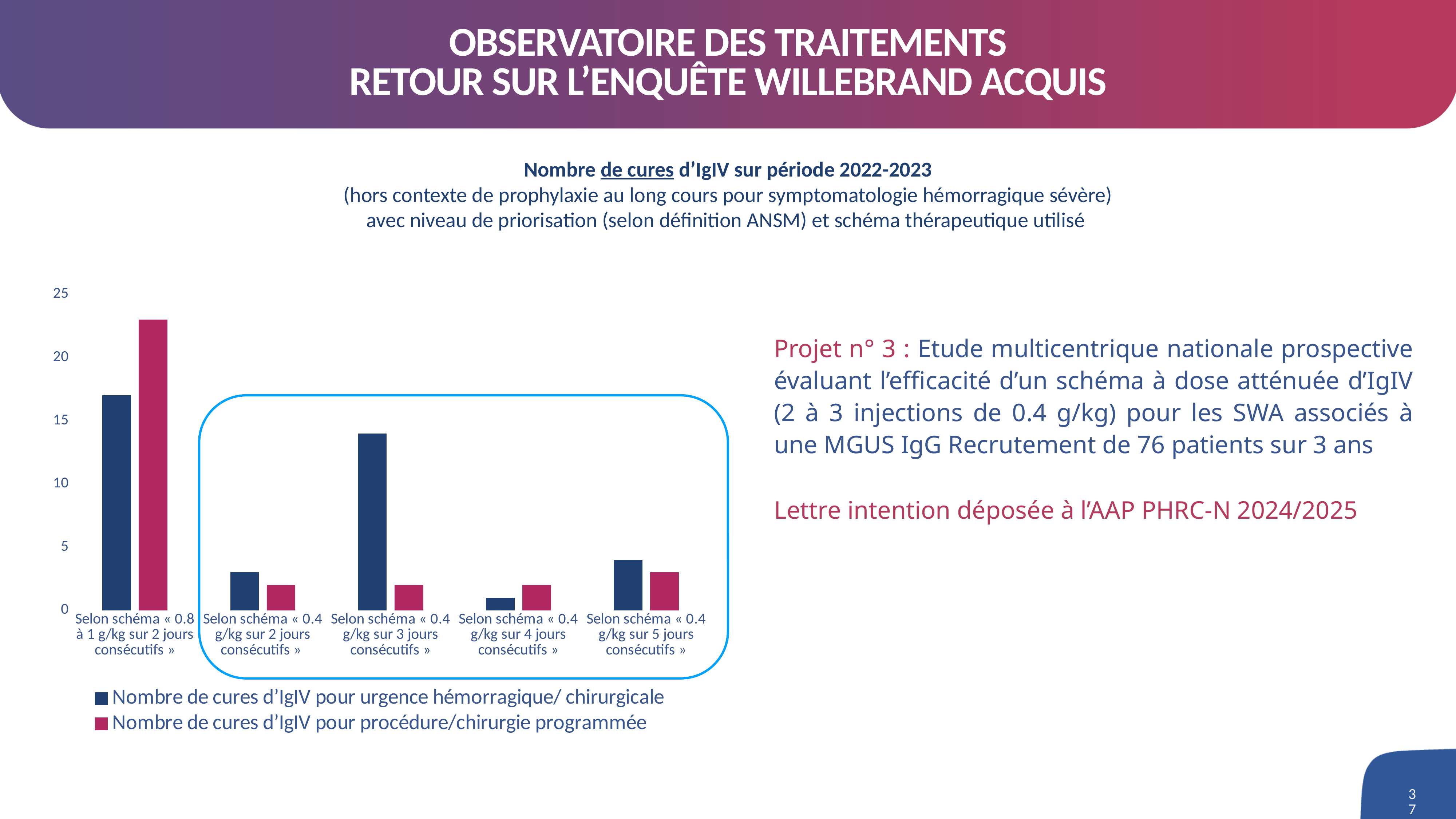
Is the value for 'Nombre de cures d'IgIV pour procédure/chirurgie programmée' in the category 'Selon schéma « 0.8 à 1 g/kg sur 2 jours consécutifs »' greater or less than 20? greater Is the value for 'Nombre de cures d'IgIV pour urgence hémorragique/ chirurgicale' in the category 'Selon schéma « 0.4 g/kg sur 5 jours consécutifs »' greater or less than 5? less Which category has the lowest value for 'Nombre de cures d'IgIV pour urgence hémorragique/ chirurgicale'? Selon schéma « 0.4 g/kg sur 4 jours consécutifs » In the category 'Selon schéma « 0.8 à 1 g/kg sur 2 jours consécutifs »', which series has the larger value: urgence hémorragique/ chirurgicale or procédure/chirurgie programmée? Nombre de cures d'IgIV pour procédure/chirurgie programmée In the category 'Selon schéma « 0.4 g/kg sur 3 jours consécutifs »', which series has the larger value: urgence hémorragique/ chirurgicale or procédure/chirurgie programmée? Nombre de cures d'IgIV pour urgence hémorragique/ chirurgicale How many treatment schema categories are shown on the x axis of the chart? 5 What colour are the bars for 'Nombre de cures d'IgIV pour procédure/chirurgie programmée'? pink/red What kind of chart is shown on the slide? bar chart Which category has the highest value for 'Nombre de cures d'IgIV pour procédure/chirurgie programmée'? Selon schéma « 0.8 à 1 g/kg sur 2 jours consécutifs » How many series does the chart legend list? 2 Is the value for 'Nombre de cures d'IgIV pour urgence hémorragique/ chirurgicale' in the category 'Selon schéma « 0.4 g/kg sur 3 jours consécutifs »' greater or less than 10? greater Which category has the highest value for 'Nombre de cures d'IgIV pour urgence hémorragique/ chirurgicale'? Selon schéma « 0.8 à 1 g/kg sur 2 jours consécutifs »